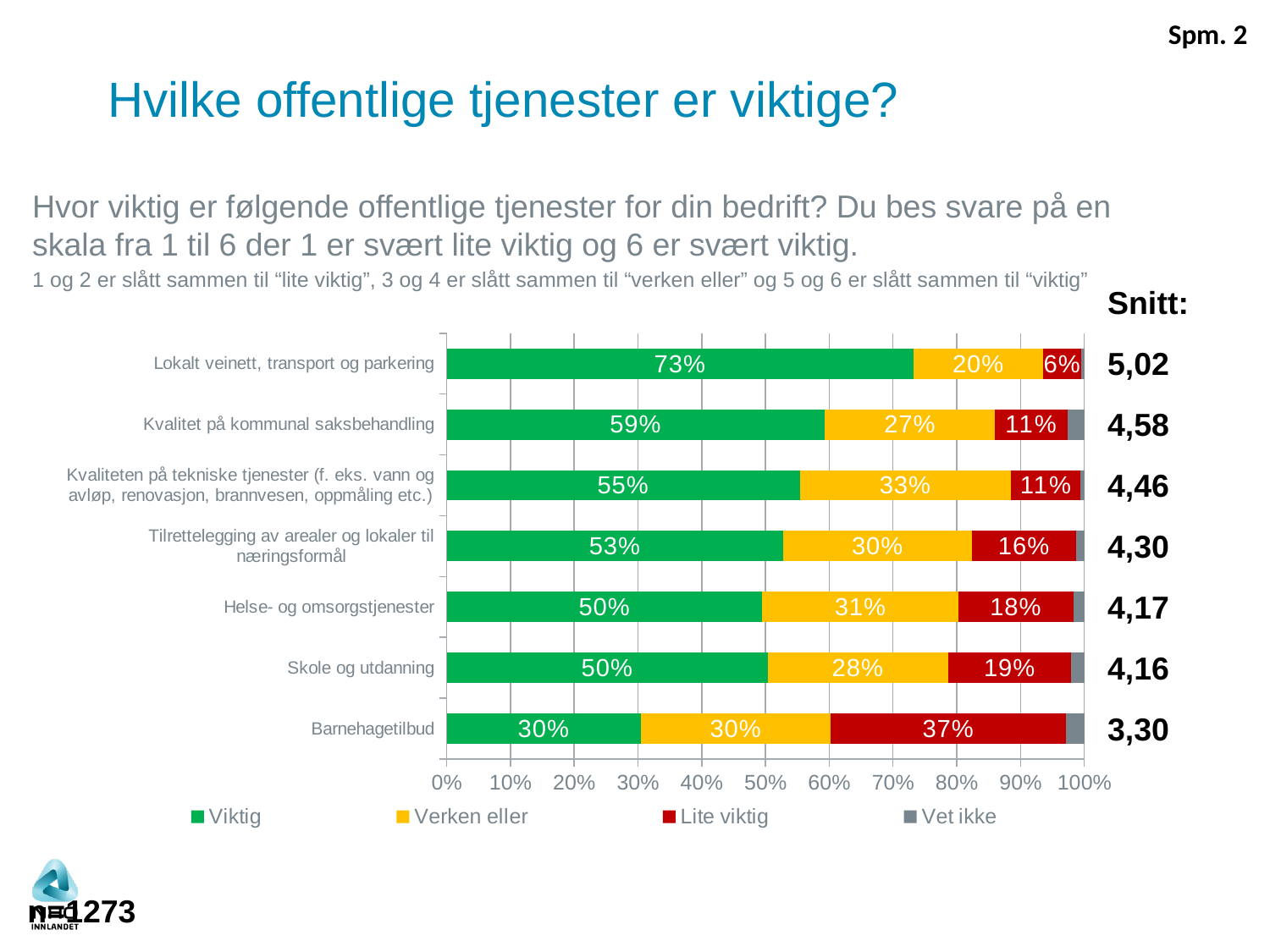
What is the Snitt (average) value shown for Barnehagetilbud? 3,30 How many public service categories are shown in the chart? 7 What is the Lite viktig share for Barnehagetilbud? 37% Which category has the highest Viktig share? Lokalt veinett, transport og parkering Which has the larger Verken eller share: "Kvalitet på kommunal saksbehandling" or "Helse- og omsorgstjenester"? Helse- og omsorgstjenester What is the Verken eller share for "Kvaliteten på tekniske tjenester (f. eks. vann og avløp, renovasjon, brannvesen, oppmåling etc.)"? 33% Which category has the lowest Viktig share? Barnehagetilbud What type of chart is shown on the slide? Stacked bar chart How many percentage points higher is the Viktig share for "Lokalt veinett, transport og parkering" than for "Kvalitet på kommunal saksbehandling"? 14 percentage points How many series does the legend list? 4 What percentage of respondents rated "Lokalt veinett, transport og parkering" as Viktig? 73% Which category has the highest Lite viktig share? Barnehagetilbud